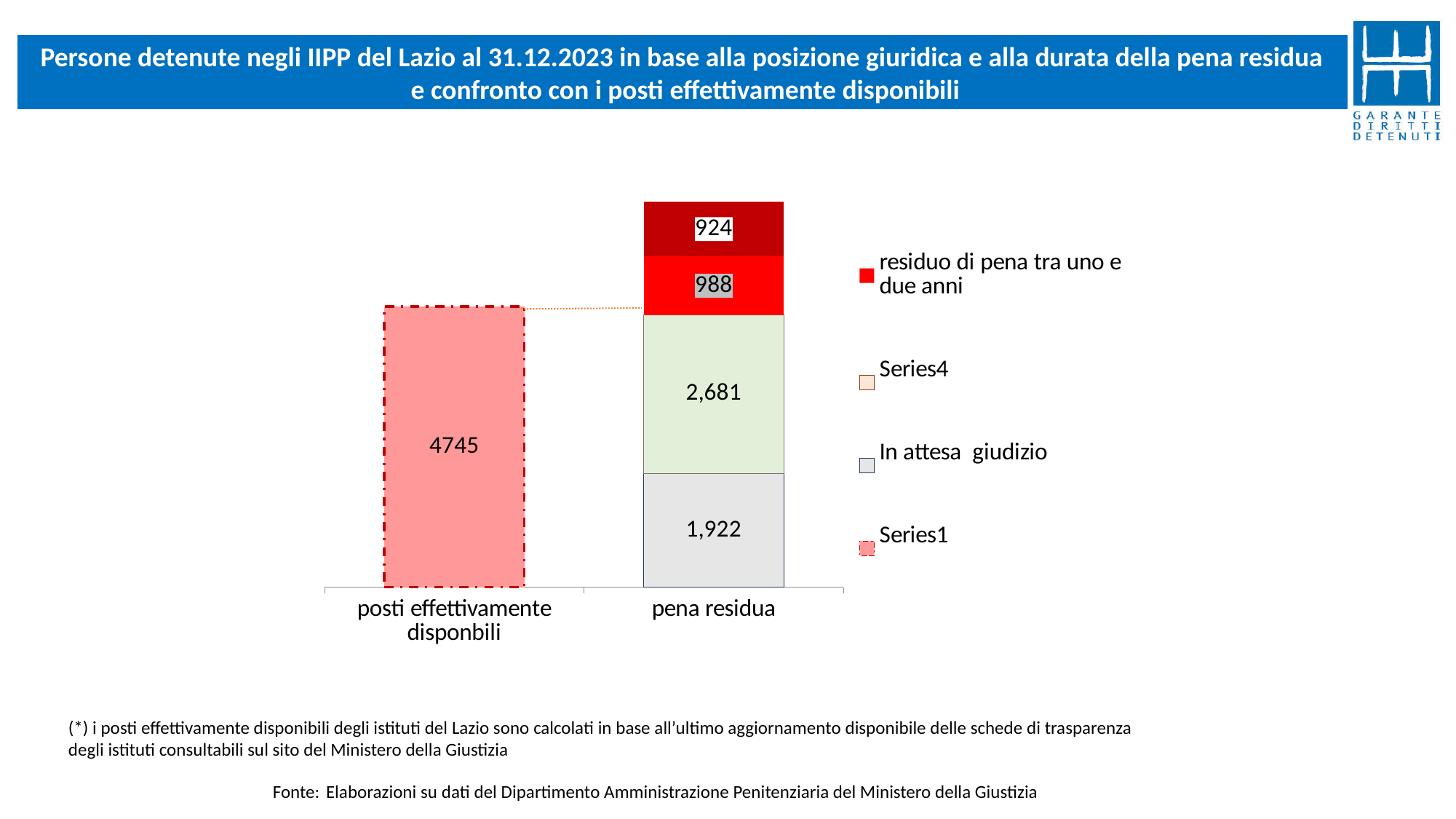
Which is larger in the 'pena residua' bar: the 'residuo di pena tra uno e due anni' segment or the top dark red segment? residuo di pena tra uno e due anni How many categories are shown on the x axis of the chart? 2 What is the value of the 'In attesa giudizio' segment in the 'pena residua' bar? 1,922 What is the value of the 'residuo di pena tra uno e due anni' segment in the 'pena residua' bar? 988 Which legend entry corresponds to the pink bar for 'posti effettivamente disponbili'? Series1 What is the difference between the 988 segment and the 924 segment in the 'pena residua' bar? 64 What is the value of the largest segment in the 'pena residua' stacked bar? 2,681 What is the difference between the 2,681 segment and the 1,922 segment in the 'pena residua' bar? 759 What is the value shown for 'posti effettivamente disponbili'? 4745 How many series does the chart legend list? 4 What is the total of all segments in the 'pena residua' stacked bar? 6,515 What kind of chart is shown on the slide? bar chart